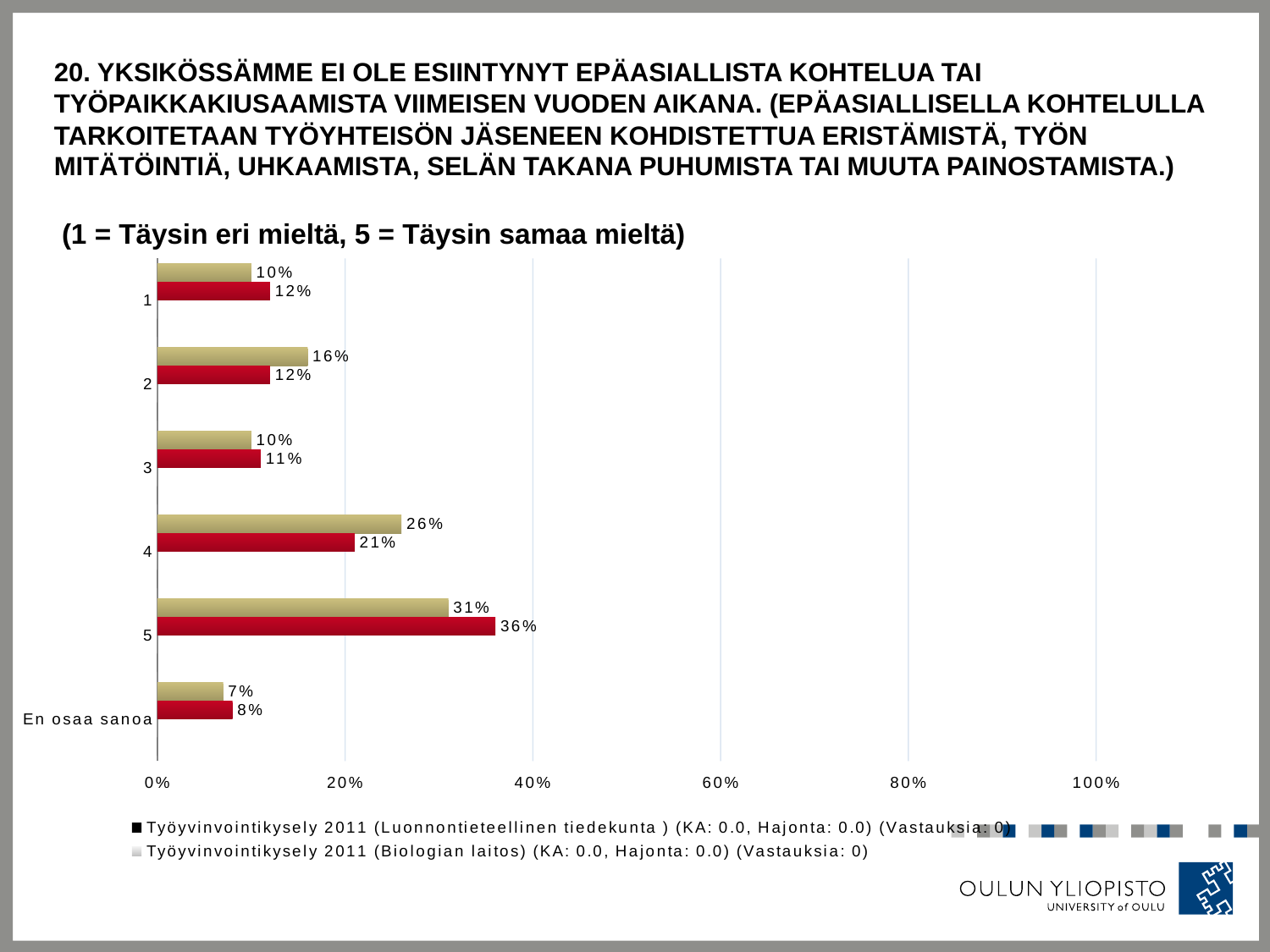
What is the value of the red bar for category 5? 36% Which category has the highest value for the red bars? 5 For category 4, which bar is larger, the red bar or the tan bar? the tan bar Which category has the lowest value for the tan bars? En osaa sanoa What is the value of the tan bar for category 2? 16% What is the value of the tan bar for category 4? 26% What type of chart is shown on the slide? bar chart What is the value of the red bar for 'En osaa sanoa'? 8% What is the difference between the red bar and the tan bar for category 5? 5% How many categories are shown on the vertical axis of the chart? 6 How many series does the legend list? 2 Is the value of the red bar for category 5 greater or less than 40%? less